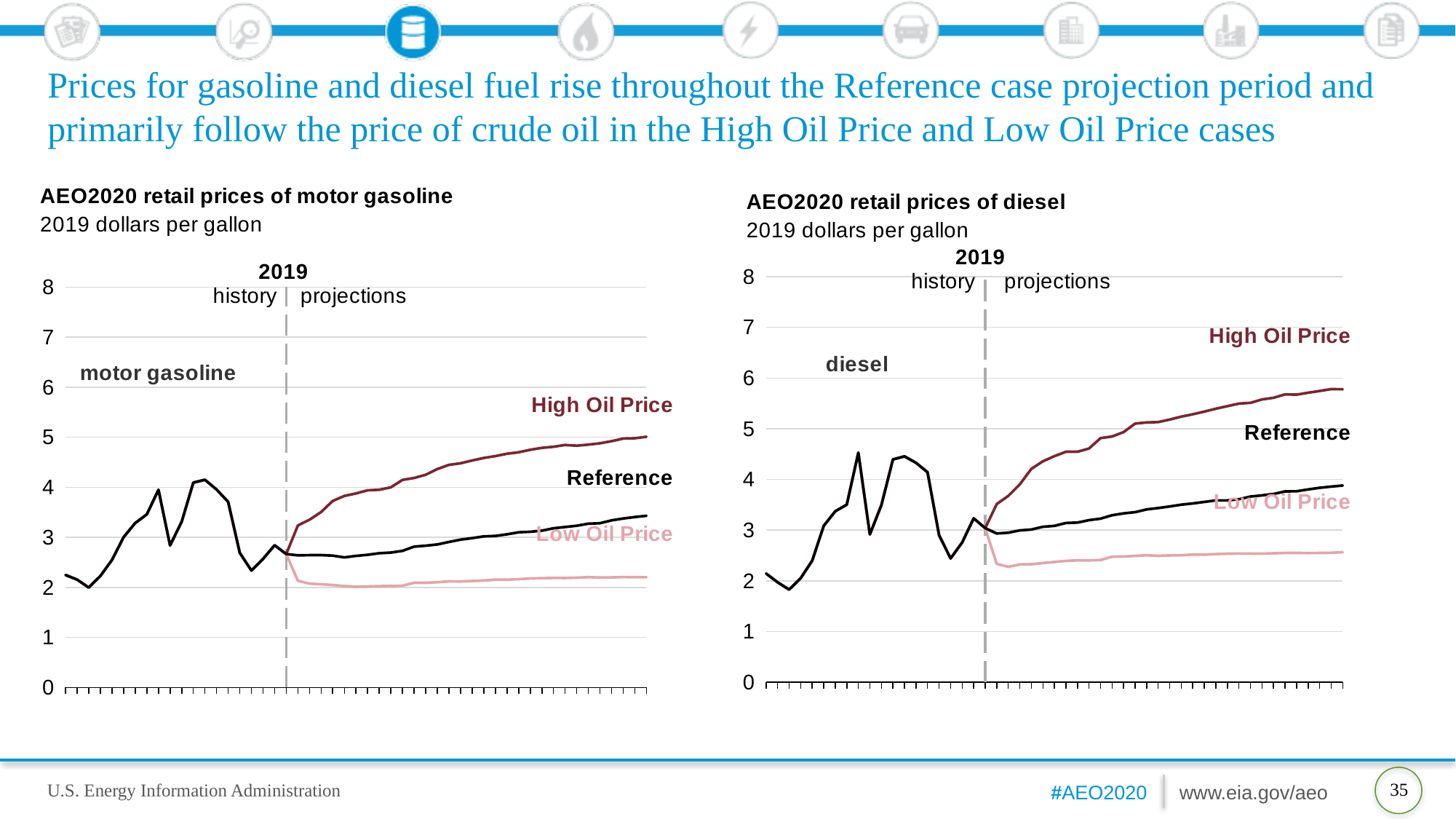
How many projection cases are labeled on the AEO2020 retail prices of diesel chart? 3 What kind of chart is the AEO2020 retail prices of motor gasoline chart? line chart What unit is used on the y axis of the AEO2020 retail prices of motor gasoline chart? 2019 dollars per gallon On the AEO2020 retail prices of diesel chart, which year does the dashed line separating history from projections mark? 2019 On the AEO2020 retail prices of diesel chart, does the Reference case price rise or fall over the projection period? rise On the AEO2020 retail prices of diesel chart, is the High Oil Price value at the end of the projection period greater or less than 5? greater On the AEO2020 retail prices of motor gasoline chart, which case has the lowest price at the end of the projection period? Low Oil Price On the AEO2020 retail prices of motor gasoline chart, is the High Oil Price value at the end of the projection period greater or less than 4? greater On the AEO2020 retail prices of motor gasoline chart, which is higher at the end of the projection period, the Reference case or the Low Oil Price case? Reference On the AEO2020 retail prices of motor gasoline chart, is the Low Oil Price value at the end of the projection period greater or less than 3? less On the AEO2020 retail prices of diesel chart, which case has the highest price at the end of the projection period? High Oil Price